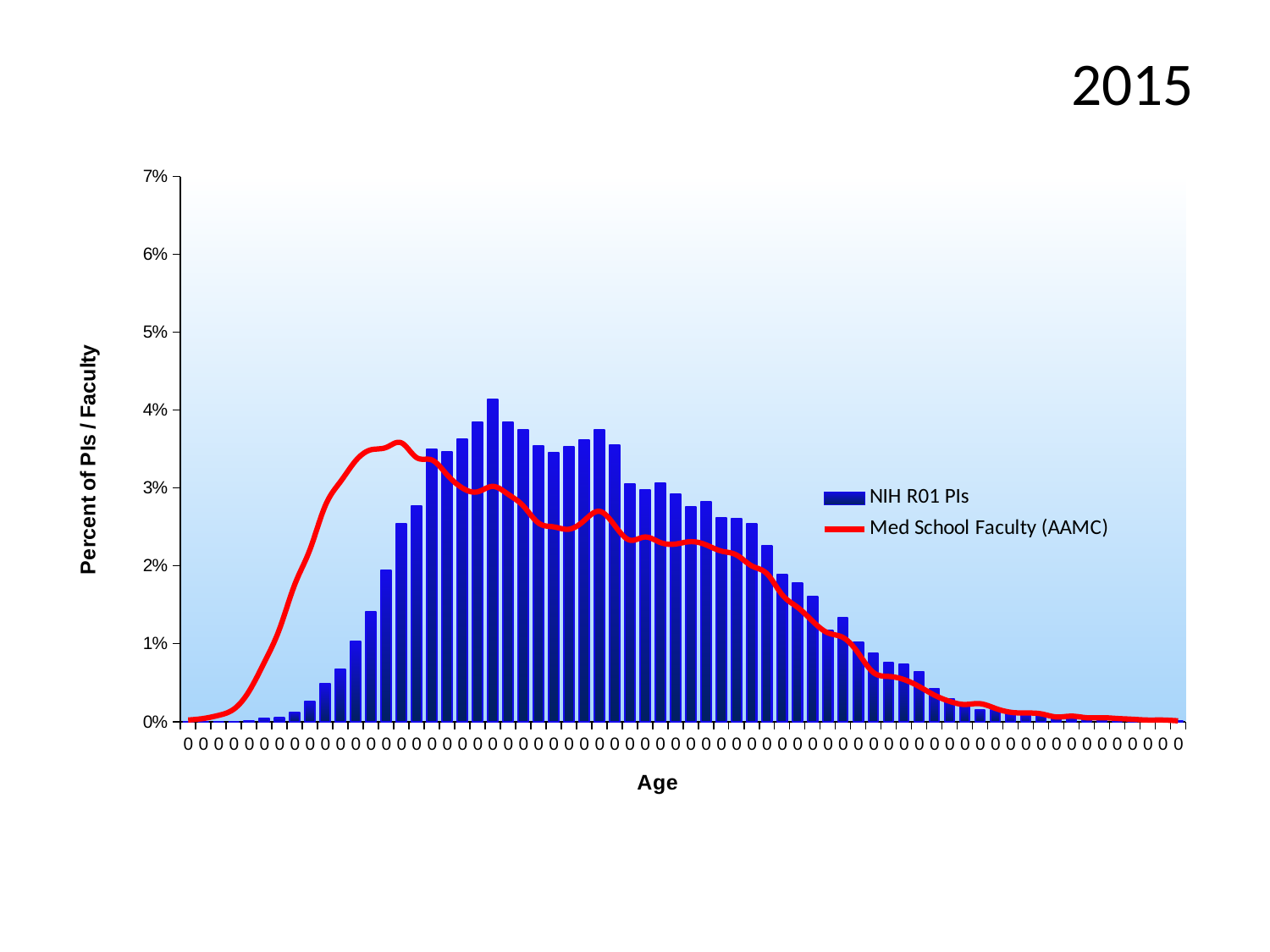
Is the peak of the Med School Faculty (AAMC) line greater or less than 4%? less Is the peak of the Med School Faculty (AAMC) line greater or less than 3%? greater What kind of chart is used for the NIH R01 PIs series? bar chart How many tick labels are shown on the vertical axis? 8 Which series reaches a higher peak value, NIH R01 PIs or Med School Faculty (AAMC)? NIH R01 PIs What are the two series named in the legend? NIH R01 PIs and Med School Faculty (AAMC) What is the highest value labelled on the vertical axis? 7% Across the right half of the chart, do the values of the Med School Faculty (AAMC) line rise or fall as age increases? fall What year is shown as the title at the top of the slide? 2015 How many series does the legend list? 2 Is the tallest NIH R01 PIs bar greater or less than 4%? greater